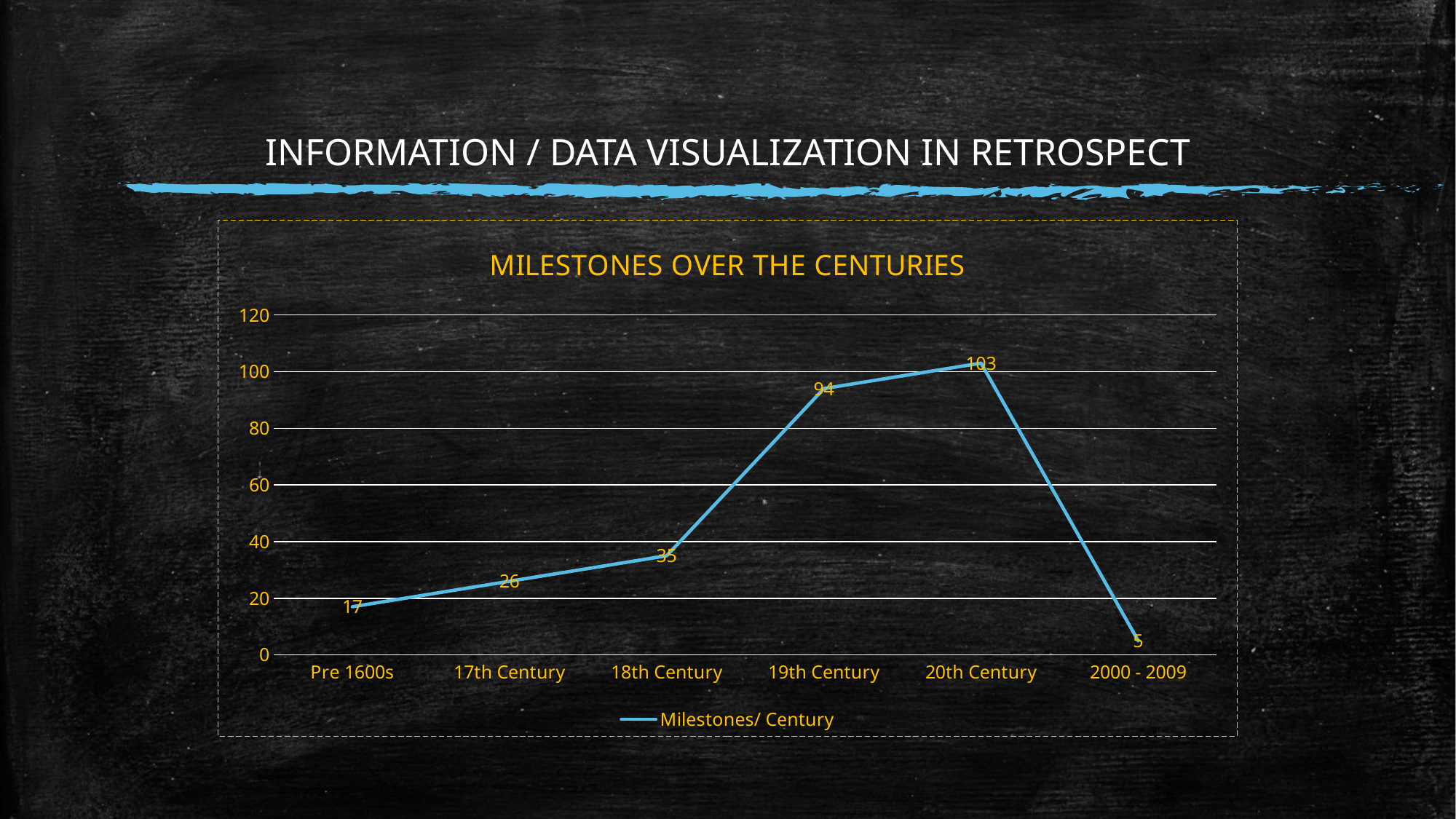
What kind of chart is shown? line chart Is the value for the 18th Century greater or less than 40? less What is the title of the chart? MILESTONES OVER THE CENTURIES What is the difference between the values for the 20th Century and the 19th Century? 9 How many series does the legend list? 1 Which is larger, the value for the 18th Century or the 17th Century? 18th Century What is the value for the 19th Century? 94 What is the value for Pre 1600s? 17 How many categories are shown on the x axis? 6 Which category has the lowest value? 2000 - 2009 What is the value for 2000 - 2009? 5 Which category has the highest value? 20th Century